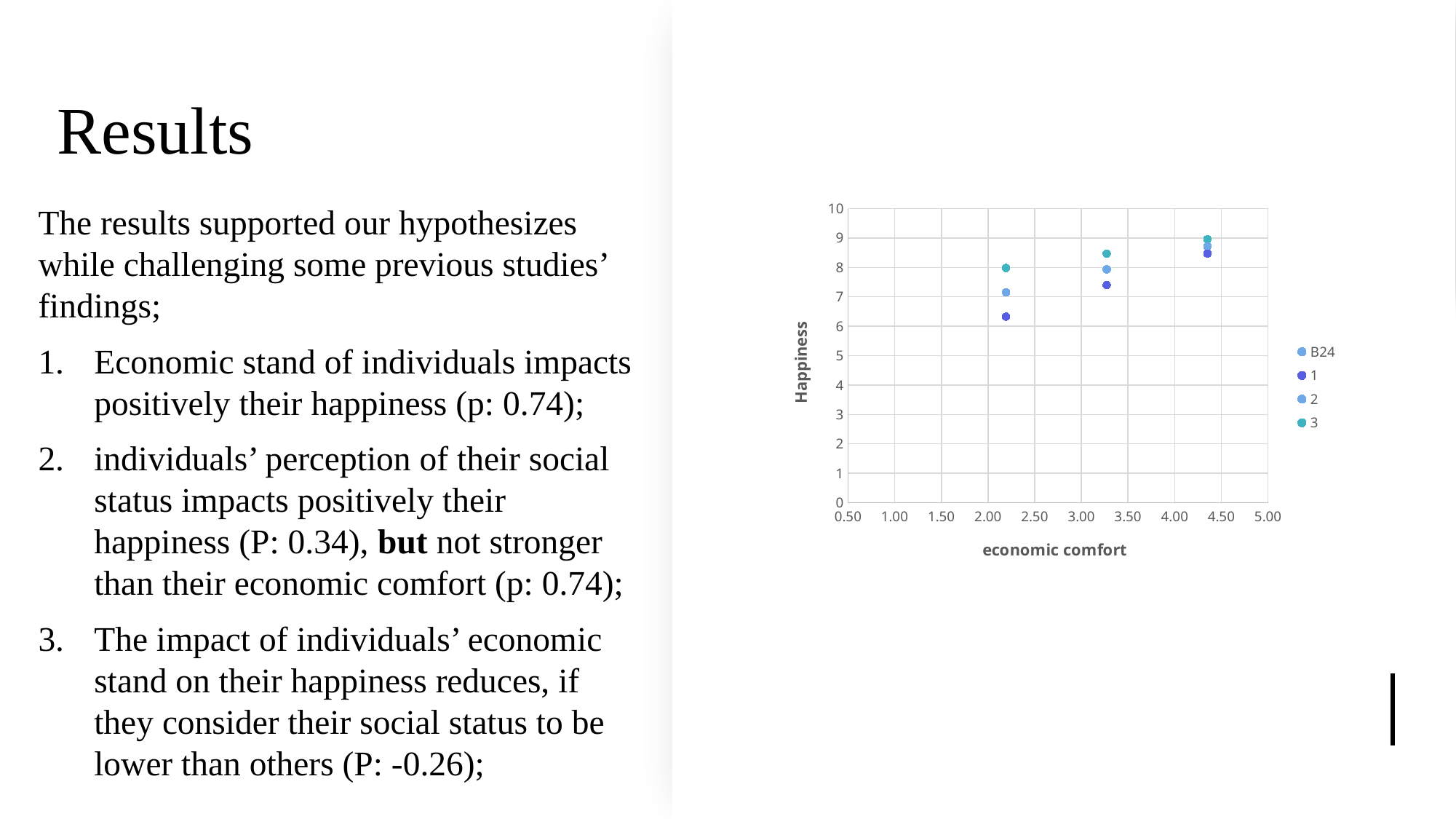
Is the Happiness value for series 1 at the middle economic comfort level (around 3.25) greater or less than 8? less Is the Happiness value for series 2 at the highest economic comfort level (around 4.35) greater or less than 8? greater How many series does the chart's legend list? 4 Which series has the highest Happiness value at every economic comfort level plotted? 3 As economic comfort increases along the x axis, do the Happiness values rise or fall? rise What kind of chart is shown on the slide? scatter chart Which series has the lowest Happiness value at every economic comfort level plotted? 1 What is the title of the chart's y axis? Happiness How many distinct economic comfort levels have points plotted on the chart? 3 What is the title of the chart's x axis? economic comfort What is the maximum value shown on the chart's y axis? 10 Is the Happiness value for series 1 at the lowest economic comfort level (around 2.20) greater or less than 7? less